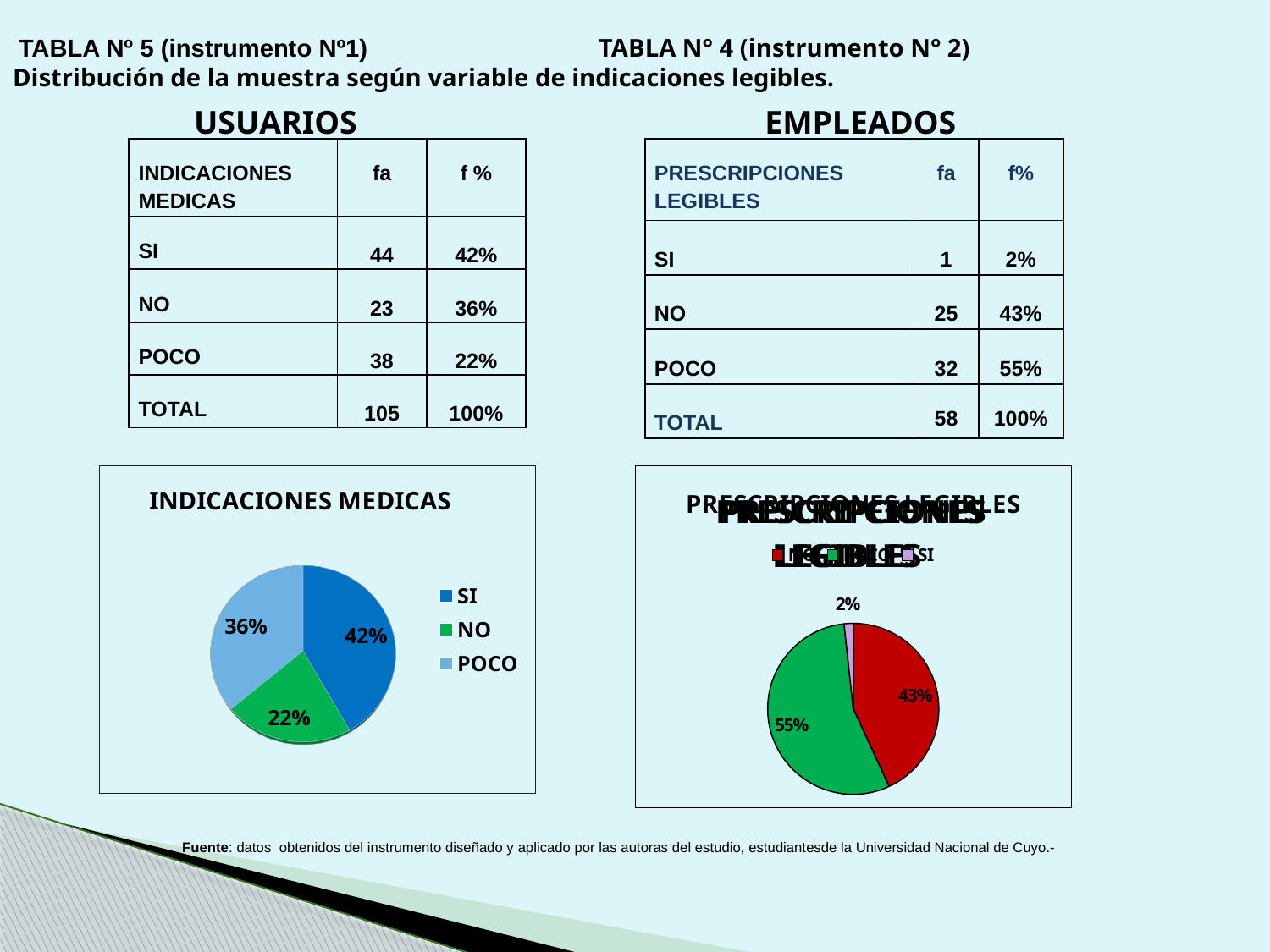
In the INDICACIONES MEDICAS pie chart, what colour is the SI slice? dark blue In the PRESCRIPCIONES LEGIBLES pie chart, what percentage is shown on the red slice? 43% In the PRESCRIPCIONES LEGIBLES pie chart, what is the percentage of the smallest slice? 2% How many slices does the PRESCRIPCIONES LEGIBLES pie chart have? 3 What type of chart is the INDICACIONES MEDICAS chart on the left? pie chart In the PRESCRIPCIONES LEGIBLES pie chart, what percentage is shown on the green slice? 55% In the INDICACIONES MEDICAS pie chart, what is the difference between the largest slice (42%) and the smallest slice (22%)? 20% In the INDICACIONES MEDICAS pie chart, what percentage is shown for SI? 42% In the INDICACIONES MEDICAS pie chart, what is the percentage shown on the smallest slice? 22% In the INDICACIONES MEDICAS pie chart, which category has the largest slice? SI What type of chart is the PRESCRIPCIONES LEGIBLES chart on the right? pie chart How many entries does the legend of the INDICACIONES MEDICAS pie chart list? 3